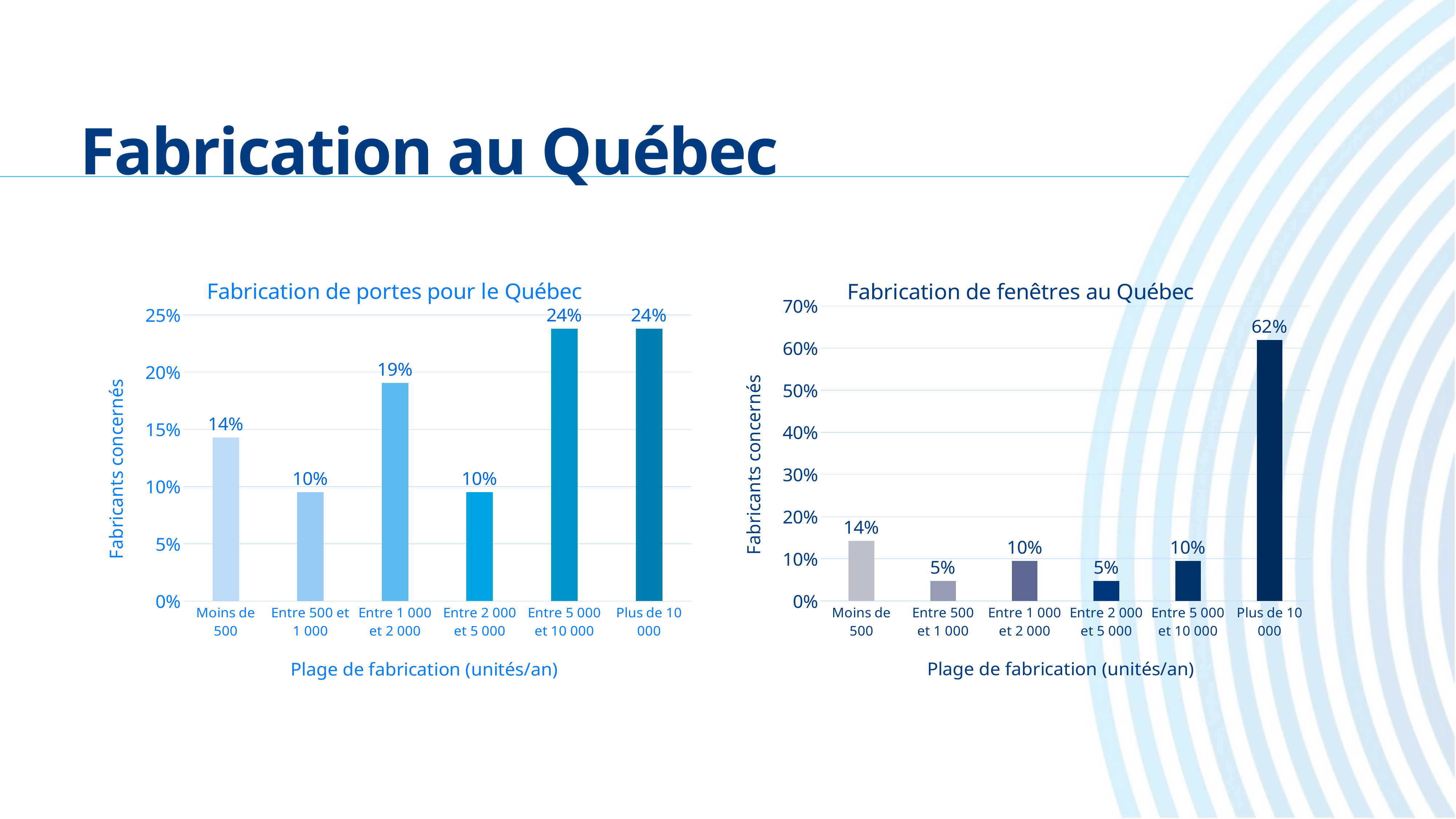
In the chart titled "Fabrication de portes pour le Québec", which is larger: the value for "Entre 1 000 et 2 000" or the value for "Entre 2 000 et 5 000"? Entre 1 000 et 2 000 In the chart titled "Fabrication de fenêtres au Québec", which category has the highest value? Plus de 10 000 In the chart titled "Fabrication de portes pour le Québec", what is the value for "Entre 1 000 et 2 000"? 19% In the chart titled "Fabrication de portes pour le Québec", what is the difference between the values for "Entre 1 000 et 2 000" and "Moins de 500"? 5% In the chart titled "Fabrication de portes pour le Québec", what is the value for "Moins de 500"? 14% In the chart titled "Fabrication de fenêtres au Québec", what is the difference between the values for "Plus de 10 000" and "Moins de 500"? 48% In the chart titled "Fabrication de fenêtres au Québec", is the value for "Plus de 10 000" greater or less than 50%? greater In the chart titled "Fabrication de fenêtres au Québec", what is the value for "Entre 500 et 1 000"? 5% What is the x-axis title of the chart titled "Fabrication de portes pour le Québec"? Plage de fabrication (unités/an) In the chart titled "Fabrication de fenêtres au Québec", what is the value for "Plus de 10 000"? 62% What kind of chart is the chart titled "Fabrication de fenêtres au Québec"? bar chart How many categories are shown in the chart titled "Fabrication de portes pour le Québec"? 6